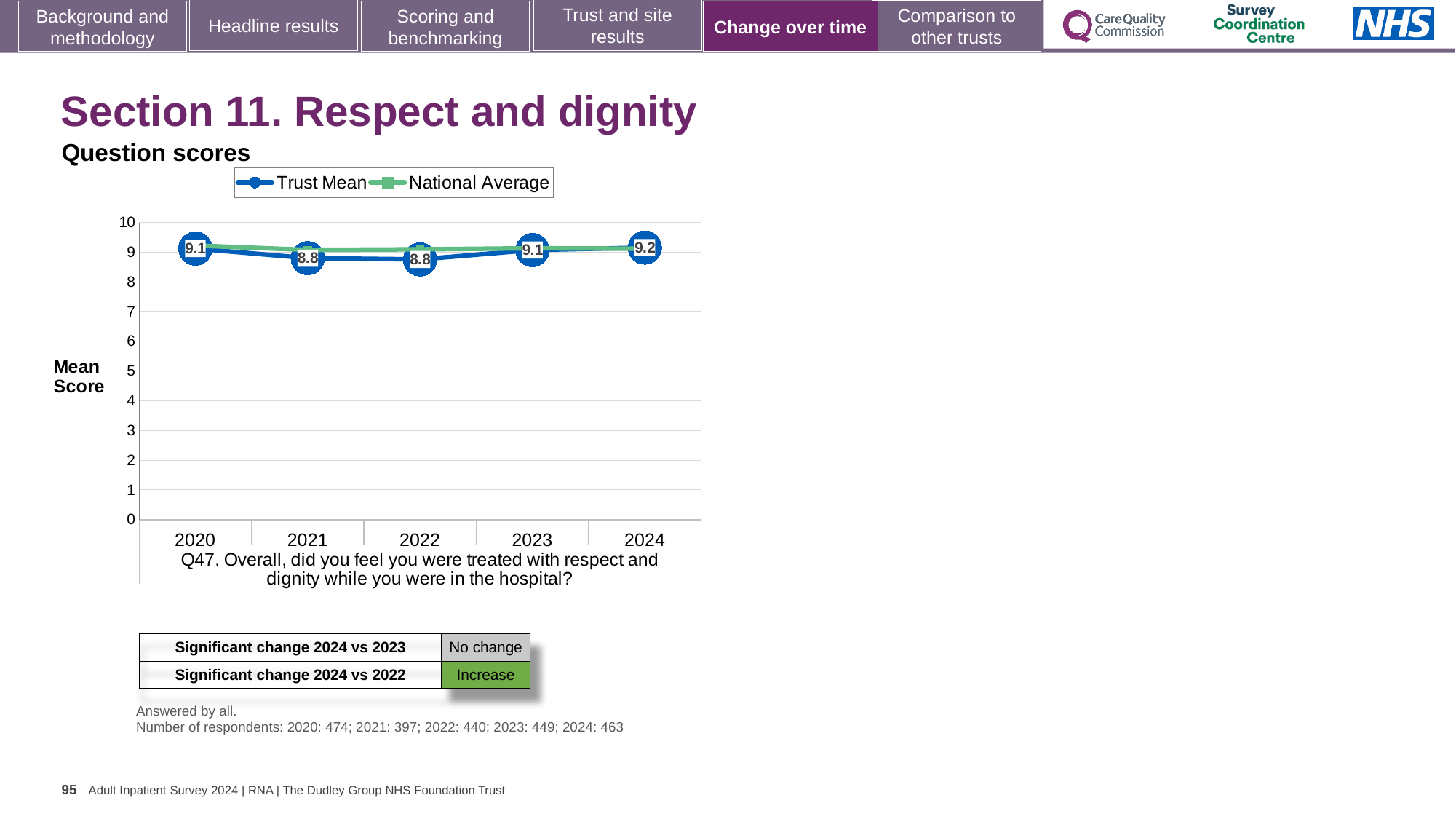
What is the Trust Mean score for 2024? 9.2 Is the National Average value for 2021 greater or less than 8? greater What is the Trust Mean score for 2020? 9.1 Which is larger, the Trust Mean score for 2020 or for 2021? 2020 What is the label on the y axis of the chart? Mean Score How many series does the chart legend list? 2 What is the difference between the Trust Mean score in 2024 and in 2021? 0.4 What is the Trust Mean score for 2021? 8.8 How many years are shown on the x axis of the chart? 5 What kind of chart is shown on the slide? line chart Does the Trust Mean score rise or fall from 2022 to 2024? rise In which year is the Trust Mean score highest? 2024